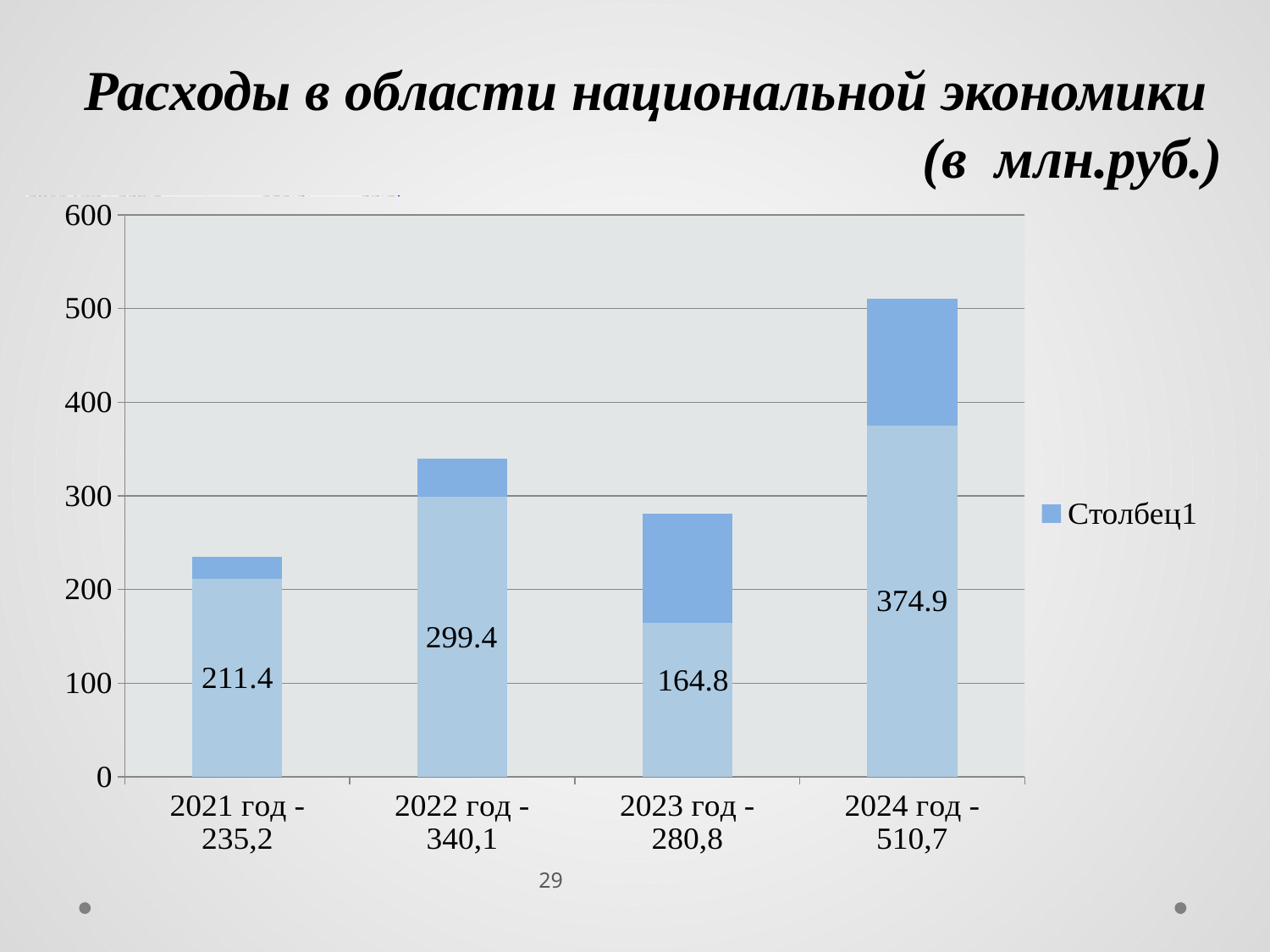
How many series does the legend list? 1 What is the labelled value of the lower segment of the bar for 2023 год? 164.8 What is the labelled value of the lower segment of the bar for 2021 год? 211.4 Which year has the highest labelled lower-segment value? 2024 год How many years (categories) are shown on the x axis? 4 What kind of chart is shown on the slide? Stacked bar chart What is the difference between the labelled lower-segment values for 2024 год and 2021 год? 163.5 Which has the larger labelled lower-segment value, 2022 год or 2023 год? 2022 год Is the total height of the bar for 2024 год greater or less than 500? greater What is the title of the chart on the slide? Расходы в области национальной экономики (в млн.руб.) Is the total height of the bar for 2021 год greater or less than 300? less Which year has the lowest labelled lower-segment value? 2023 год